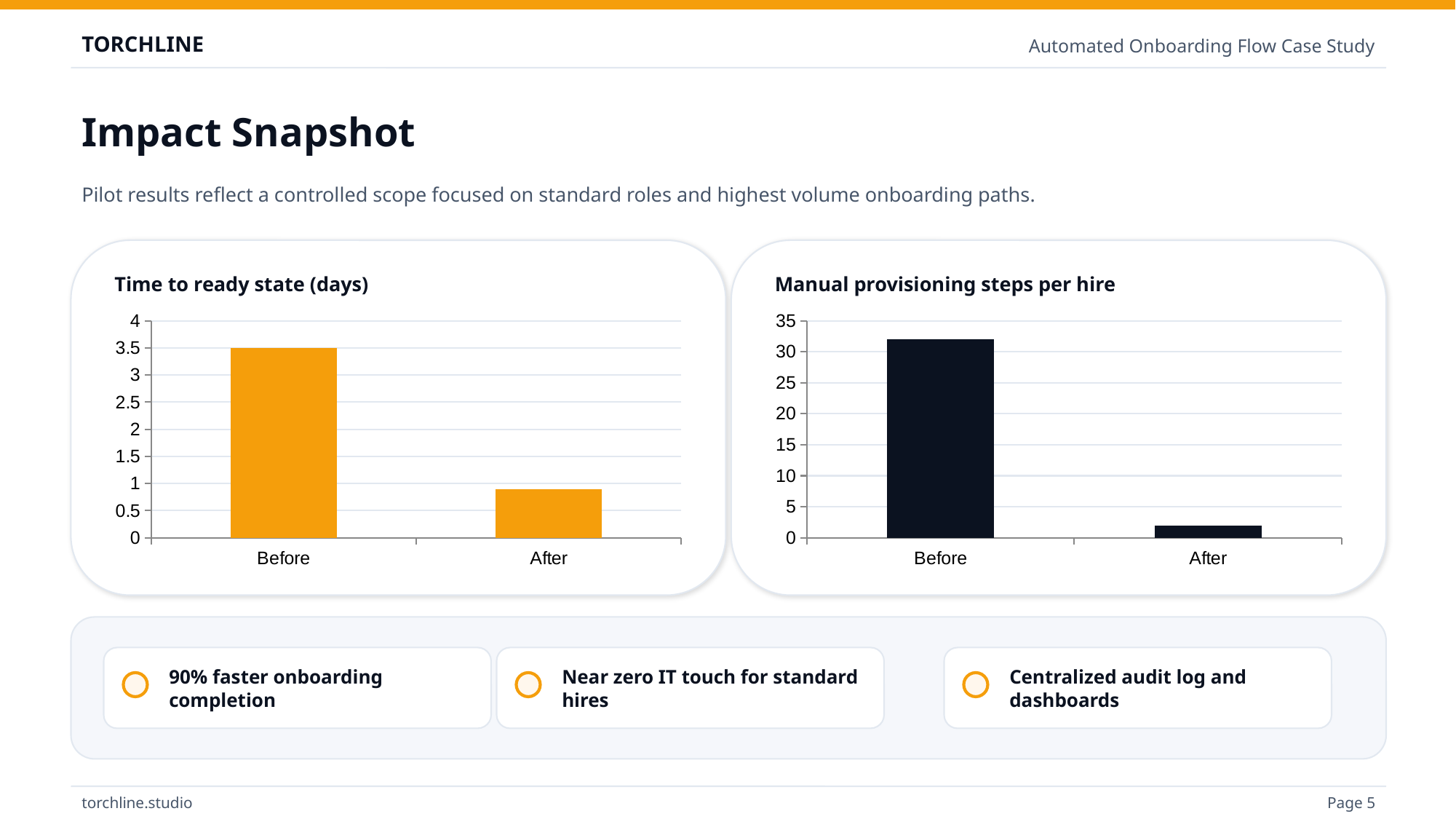
In the 'Manual provisioning steps per hire' chart, which is larger, Before or After? Before What colour are the bars in the 'Time to ready state (days)' chart? Orange What is the title of the chart on the right side of the slide? Manual provisioning steps per hire What kind of chart is the 'Manual provisioning steps per hire' chart? Bar chart In the 'Manual provisioning steps per hire' chart, is the value for After greater or less than 5? less In the 'Time to ready state (days)' chart, do the values rise or fall from Before to After? Fall In the 'Manual provisioning steps per hire' chart, which category has the lowest value? After In the 'Manual provisioning steps per hire' chart, is the value for Before greater or less than 30? greater In the 'Time to ready state (days)' chart, is the value for After greater or less than 1? less In the 'Time to ready state (days)' chart, what is the value for Before? 3.5 How many categories are shown in the 'Time to ready state (days)' chart? 2 In the 'Time to ready state (days)' chart, which category has the highest value? Before